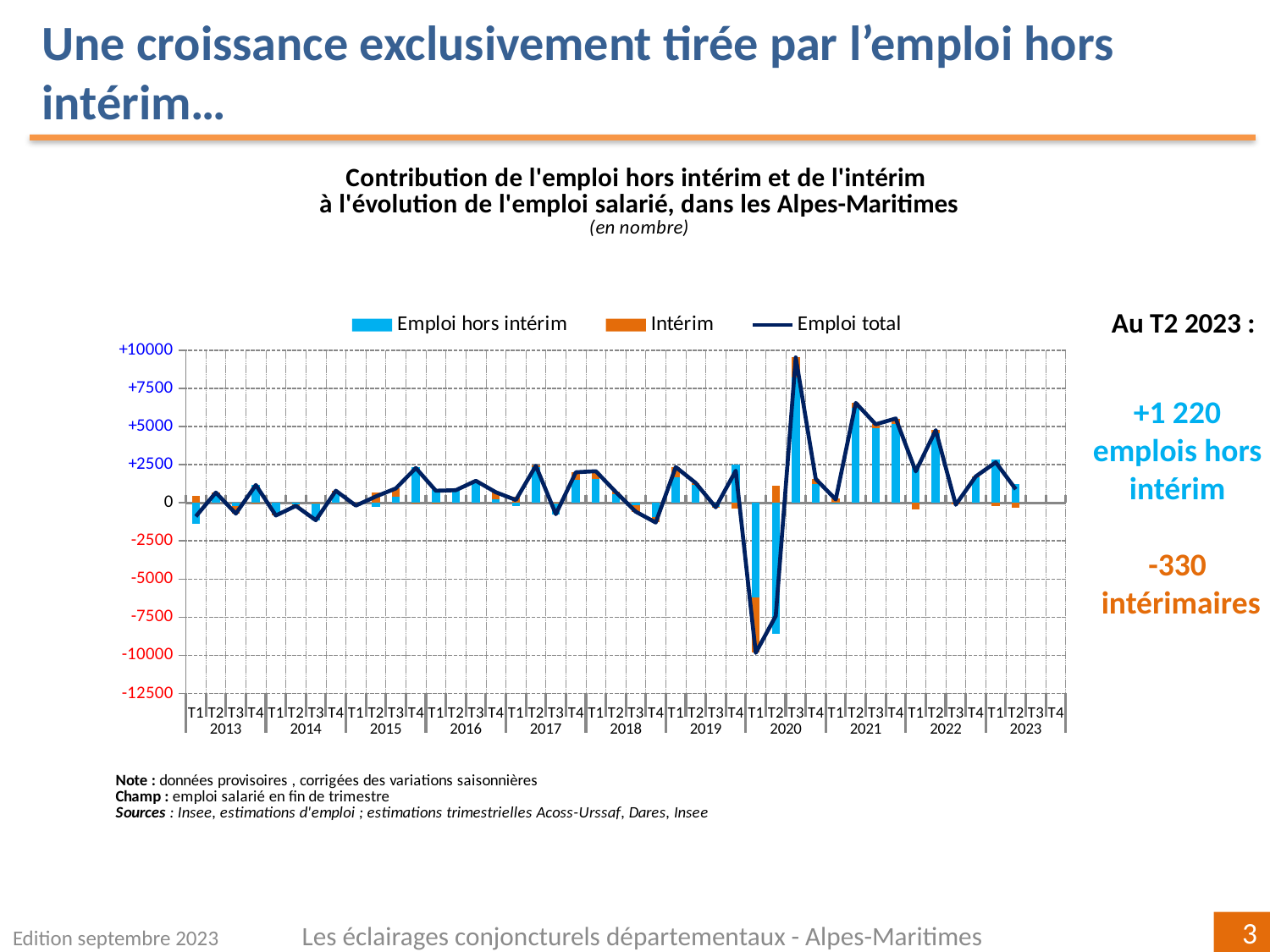
Is the value for Emploi total at T1 2020 greater or less than -7500? less Which series is drawn as a line rather than bars? Emploi total Is the value for Emploi hors intérim at T1 2020 greater or less than -5000? less Which is larger, the Emploi hors intérim bar at T3 2020 or at T2 2021? T3 2020 According to the slide, what is the value for Intérim at T2 2023? -330 In which quarter does the Emploi total line reach its lowest value? T1 2020 In which quarter does the Emploi total line reach its highest value? T3 2020 According to the slide, what is the value for Emploi hors intérim at T2 2023? +1 220 How many series does the chart legend list? 3 What kind of chart is shown on the slide? A combined bar and line chart Is the value for Emploi total at T3 2020 greater or less than 7500? greater What are the three series named in the chart legend? Emploi hors intérim, Intérim, Emploi total